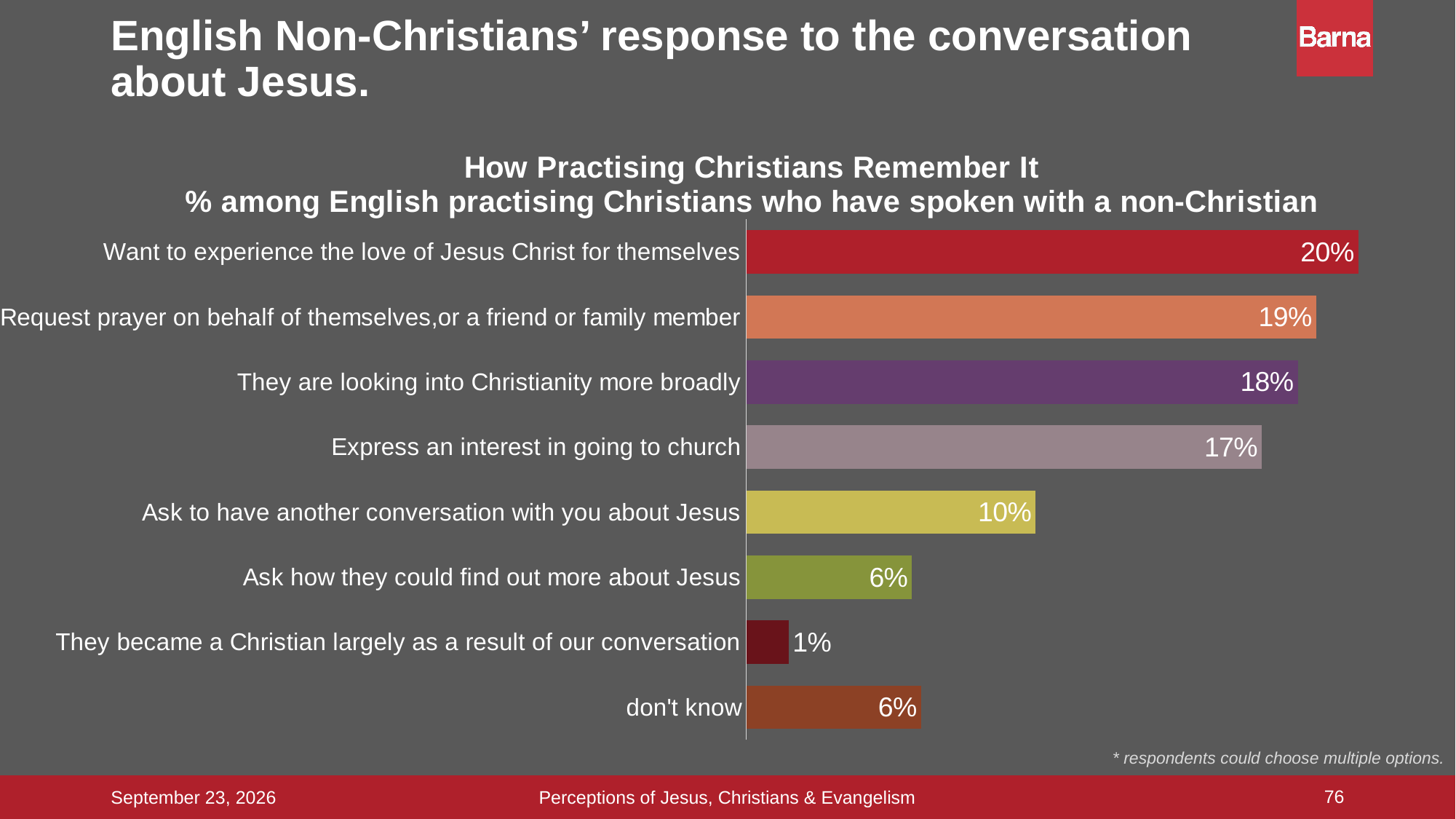
What is the value for 'Express an interest in going to church'? 17% What percentage of English practising Christians remember that the non-Christian wanted to experience the love of Jesus Christ for themselves? 20% What is the difference between 'They are looking into Christianity more broadly' and 'Ask to have another conversation with you about Jesus'? 8% Which response category has the highest value? Want to experience the love of Jesus Christ for themselves Which response category has the lowest value? They became a Christian largely as a result of our conversation What kind of chart is shown on the slide? Bar chart What is the title of the chart? How Practising Christians Remember It Which is larger: 'Ask to have another conversation with you about Jesus' or 'Ask how they could find out more about Jesus'? Ask to have another conversation with you about Jesus What is the difference between 'Want to experience the love of Jesus Christ for themselves' and 'don't know'? 14% What is the value for 'Request prayer on behalf of themselves, or a friend or family member'? 19% How many response categories are shown in the chart? 8 What is the value for 'They became a Christian largely as a result of our conversation'? 1%